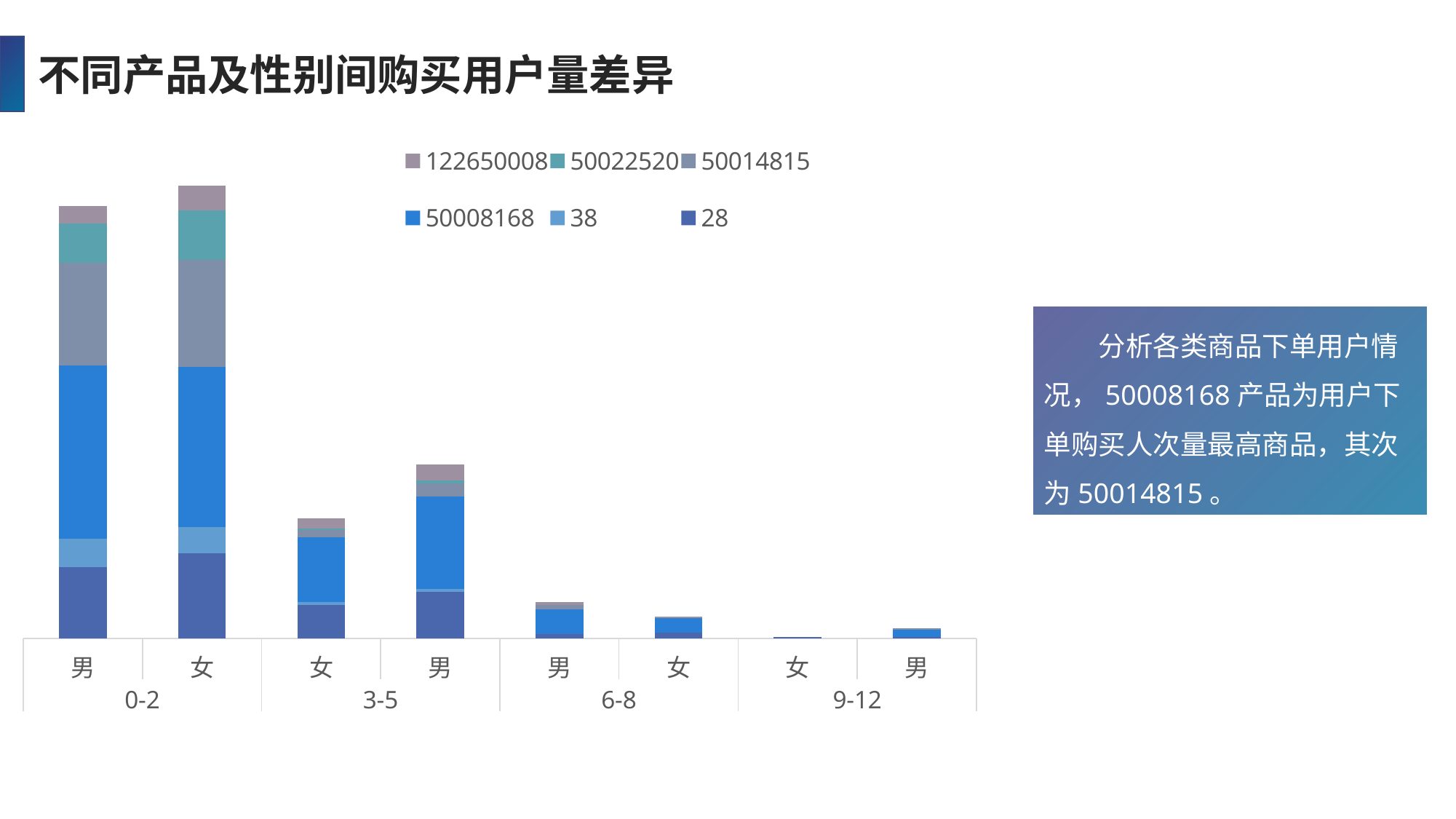
Which is taller, the 男 bar in the 0-2 group or the 男 bar in the 3-5 group? 男 in the 0-2 group Within the 3-5 group, which bar is taller, 男 or 女? 男 How many series does the legend list? 6 Which bar is the tallest in the chart? 女 in the 0-2 group Which series is listed first in the legend? 122650008 Within the 6-8 group, which bar is taller, 男 or 女? 男 What is the title of the slide containing the chart? 不同产品及性别间购买用户量差异 What kind of chart is shown on the slide? Stacked bar chart Do the bar heights generally rise or fall as the age group increases from 0-2 to 9-12? Fall Which bar is the shortest in the chart? 女 in the 9-12 group How many bars are plotted in the chart? 8 How many age groups are shown on the x axis? 4